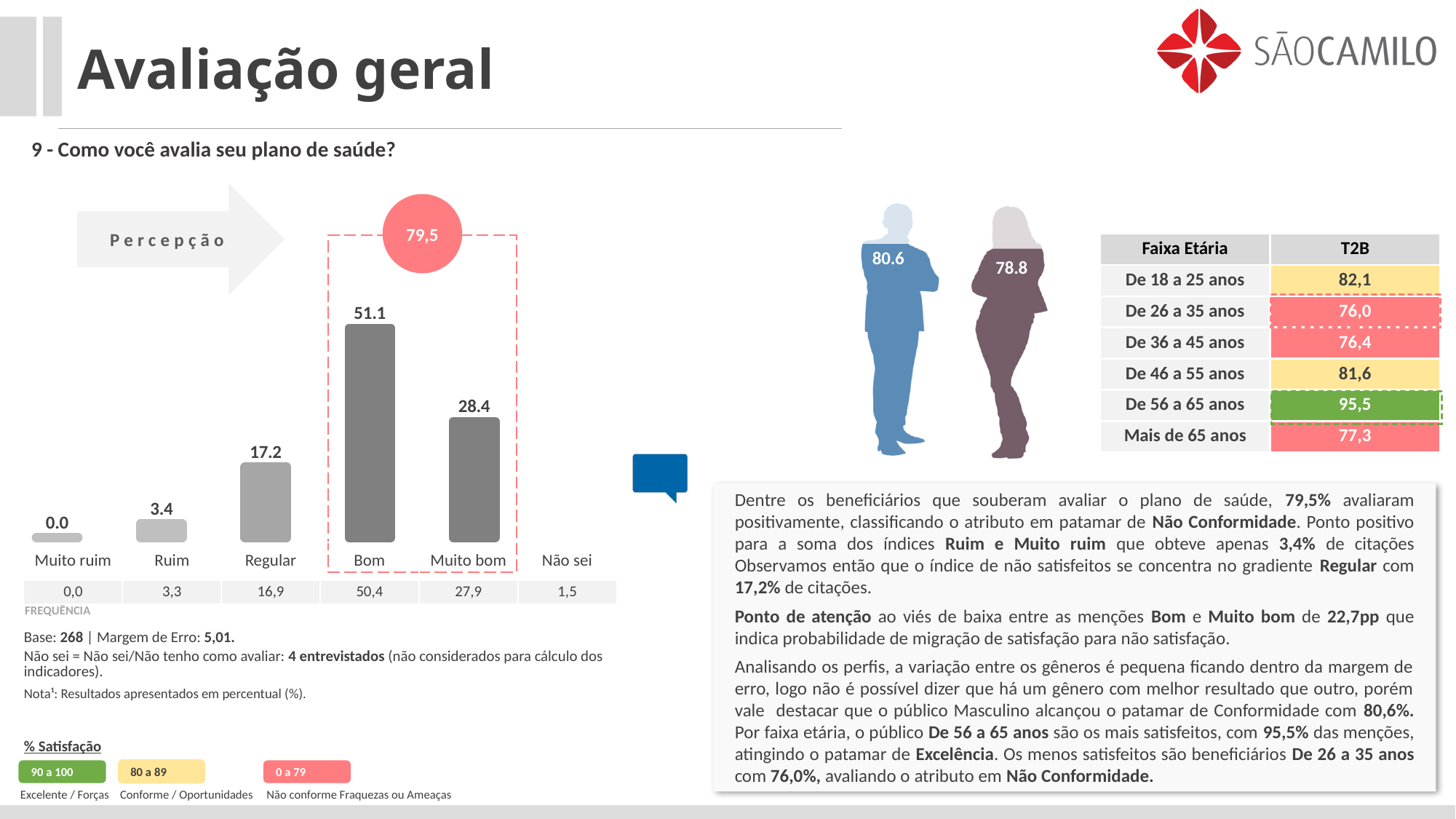
What is the value shown for the 'Bom' bar in the chart? 51.1 What type of chart is used to show the evaluation of the health plan? Bar chart What is the frequency value shown below the 'Não sei' category in the chart? 1,5 What is the difference between the 'Bom' and 'Muito bom' values in the chart? 22.7 What is the frequency value shown below the 'Bom' category in the chart? 50,4 What is the value shown for the 'Muito bom' bar in the chart? 28.4 What is the value shown for the 'Ruim' bar in the chart? 3.4 What is the value shown for the 'Regular' bar in the chart? 17.2 Which labelled category has the lowest value in the bar chart? Muito ruim What value is shown in the pink circle above the 'Bom' and 'Muito bom' bars? 79,5 Which category has the highest value in the bar chart? Bom Which is larger in the chart, the value for 'Regular' or the value for 'Muito bom'? Muito bom